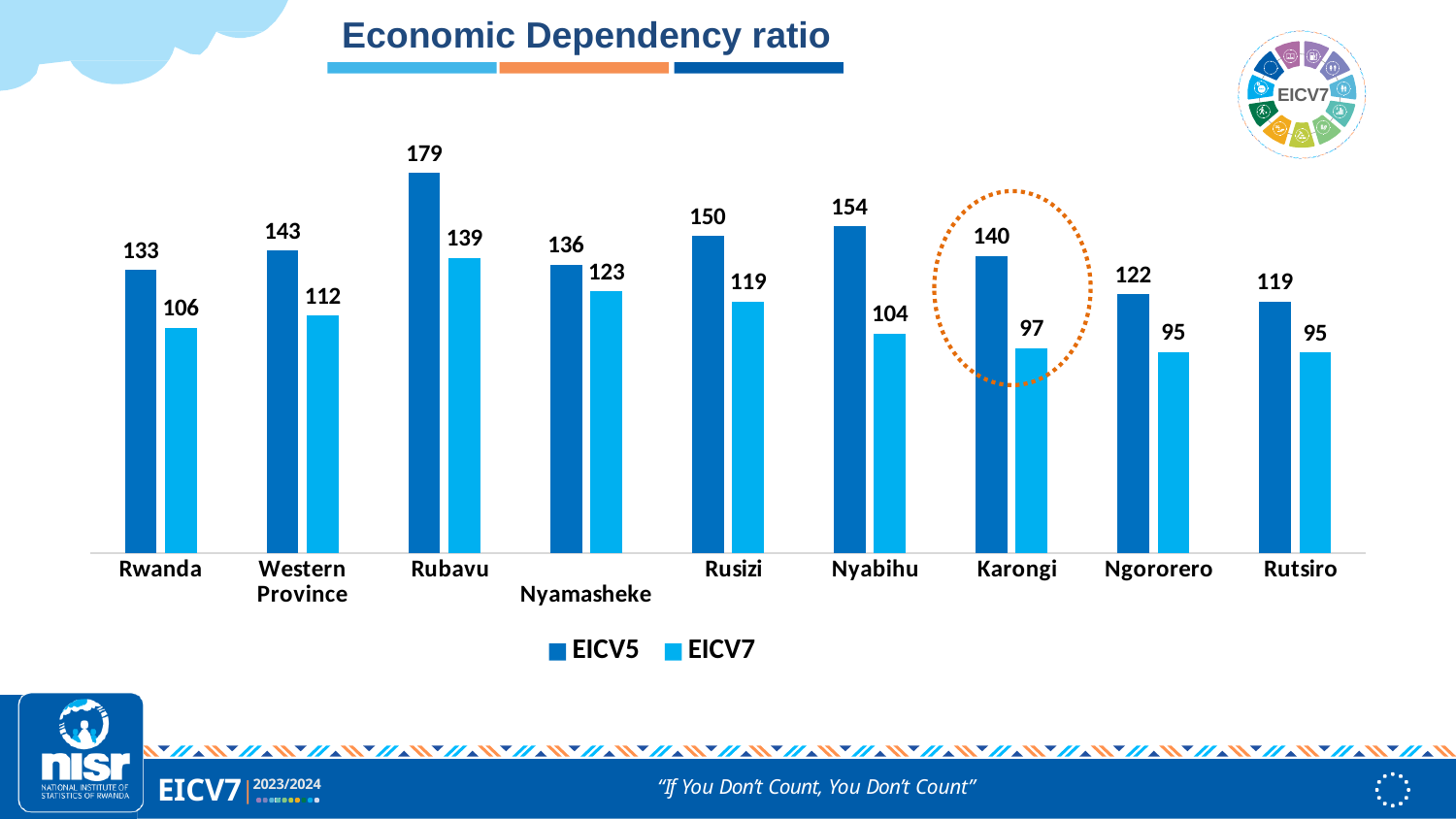
What is the title of the chart? Economic Dependency ratio Which category is highlighted with a dotted orange circle? Karongi How many series does the legend list? 2 What is the EICV5 value for Rubavu? 179 Which category has the lowest EICV5 value? Rutsiro How many categories are shown on the x axis? 9 Which is larger, the EICV7 value for Rubavu or the EICV7 value for Rusizi? Rubavu What is the EICV7 value for Karongi? 97 What is the EICV7 value for Nyamasheke? 123 What kind of chart is shown on the slide? Bar chart What is the difference between the EICV5 and EICV7 values for Nyabihu? 50 Which category has the highest EICV5 value? Rubavu